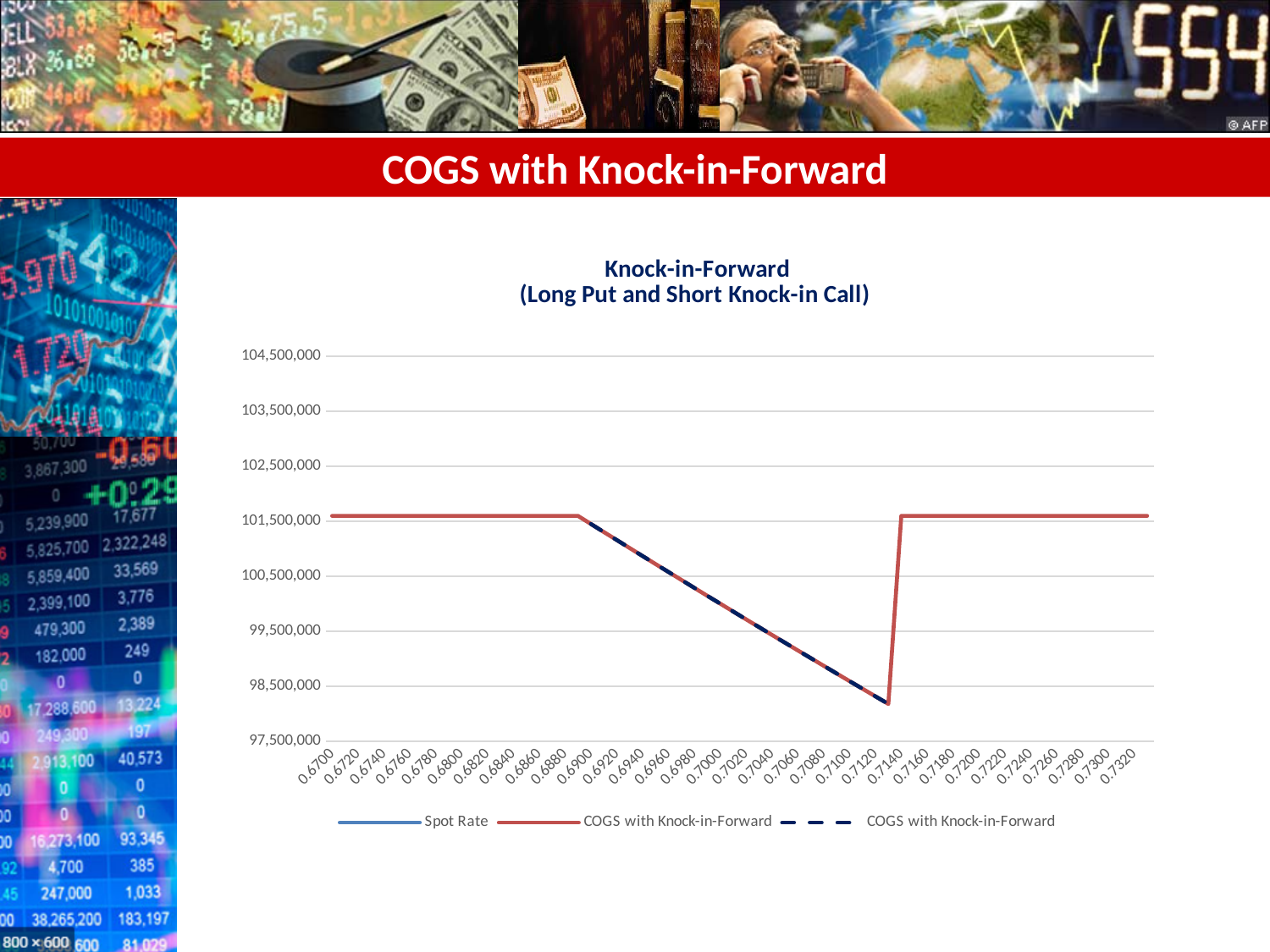
How many entries does the chart legend list? 3 Does the COGS line rise or fall between spot rates 0.6900 and 0.7120? fall What is the first legend entry in the chart? Spot Rate How many spot rate values are labelled along the x axis? 32 What is the title of the chart? Knock-in-Forward (Long Put and Short Knock-in Call) What is the lowest value labelled on the y axis? 97,500,000 Is the COGS value at spot rate 0.7120 greater or less than 98,500,000? less Is the COGS value at spot rate 0.6700 greater or less than 100,500,000? greater Is the COGS value at spot rate 0.7000 greater or less than 100,500,000? less What is the highest value labelled on the y axis? 104,500,000 What kind of chart is shown on the slide? Line chart